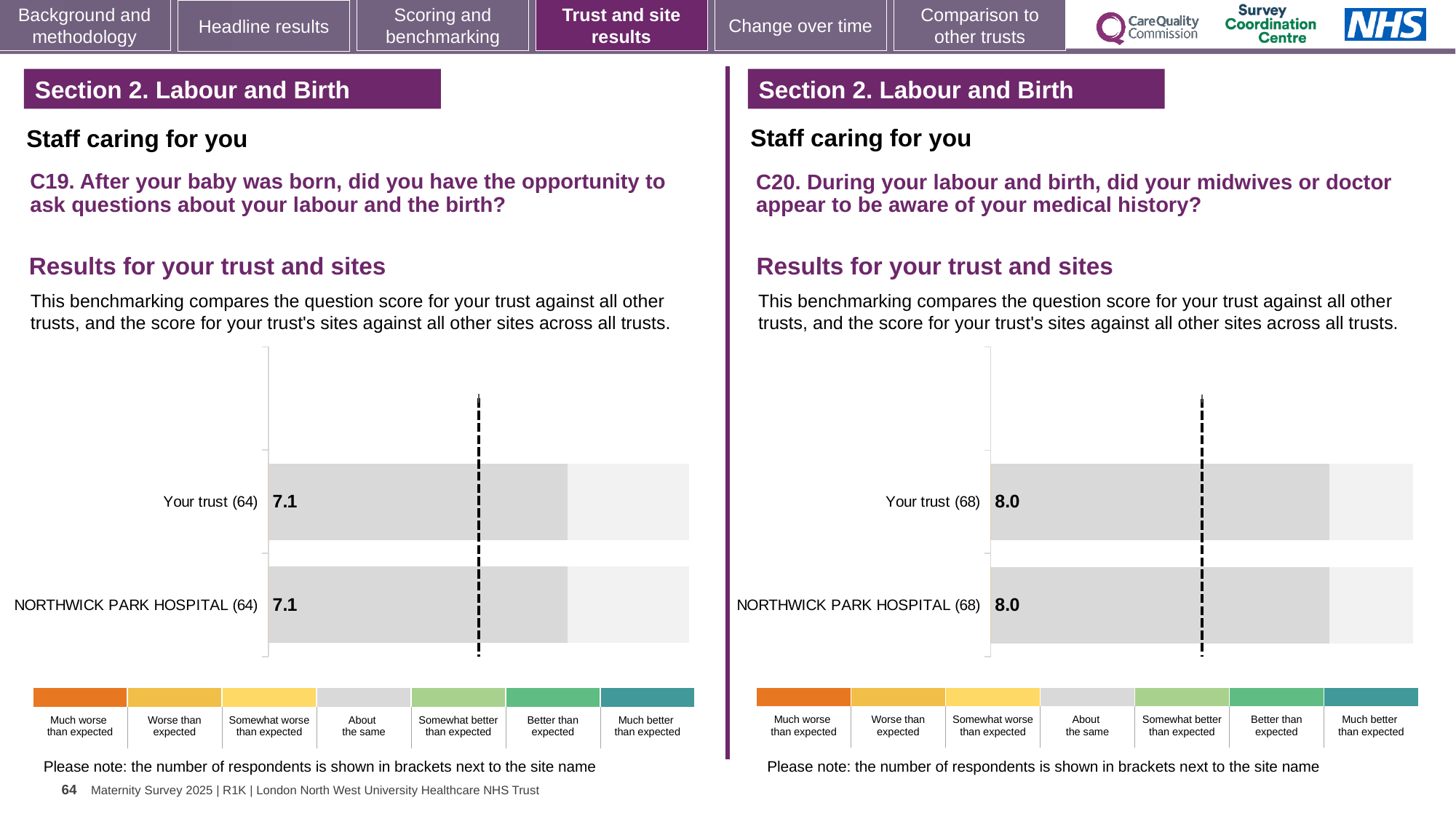
How many benchmark categories, from 'Much worse than expected' to 'Much better than expected', are shown in the colour key below the C19 chart on the left? 7 In the C19 chart on the left, what is the score for Your trust? 7.1 Is the Your trust score in the C20 chart on the right larger or smaller than the Your trust score in the C19 chart on the left? larger In the C19 chart on the left, what is the score for NORTHWICK PARK HOSPITAL? 7.1 In the C20 chart on the right, how many respondents are shown in brackets next to Your trust? 68 In the C20 chart on the right, what is the score for NORTHWICK PARK HOSPITAL? 8.0 How many bars are plotted in the C19 chart on the left? 2 What kind of chart is used in the C19 chart on the left? bar chart In the C19 chart on the left, is the score for Your trust larger than, smaller than, or the same as the score for NORTHWICK PARK HOSPITAL? the same What is the difference between the Your trust score in the C20 chart on the right and the Your trust score in the C19 chart on the left? 0.9 How many bars are plotted in the C20 chart on the right? 2 In the C20 chart on the right, what is the score for Your trust? 8.0